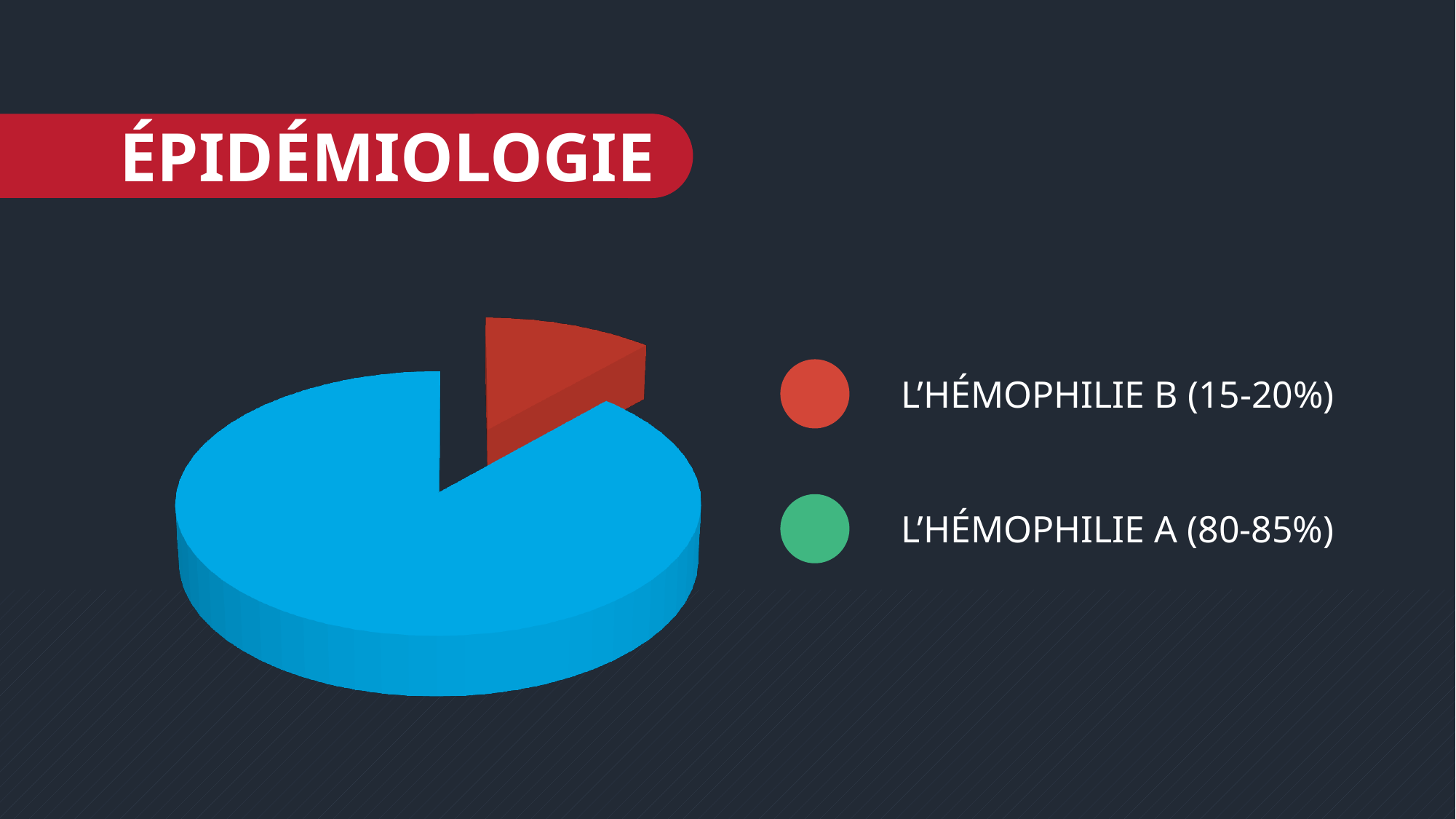
Which is larger, the slice for L'hémophilie A or the slice for L'hémophilie B? L'hémophilie A What share of the pie is given for L'hémophilie A in the legend? 80-85% How many entries does the legend list? 2 Which category has the largest slice of the pie? L'hémophilie A What kind of chart is shown on the slide? pie chart What share of the pie is given for L'hémophilie B in the legend? 15-20% Which category has the smallest slice of the pie? L'hémophilie B How many slices does the pie chart have? 2 What is the title shown on the slide above the chart? ÉPIDÉMIOLOGIE Which category is represented by the red slice of the pie? L'hémophilie B